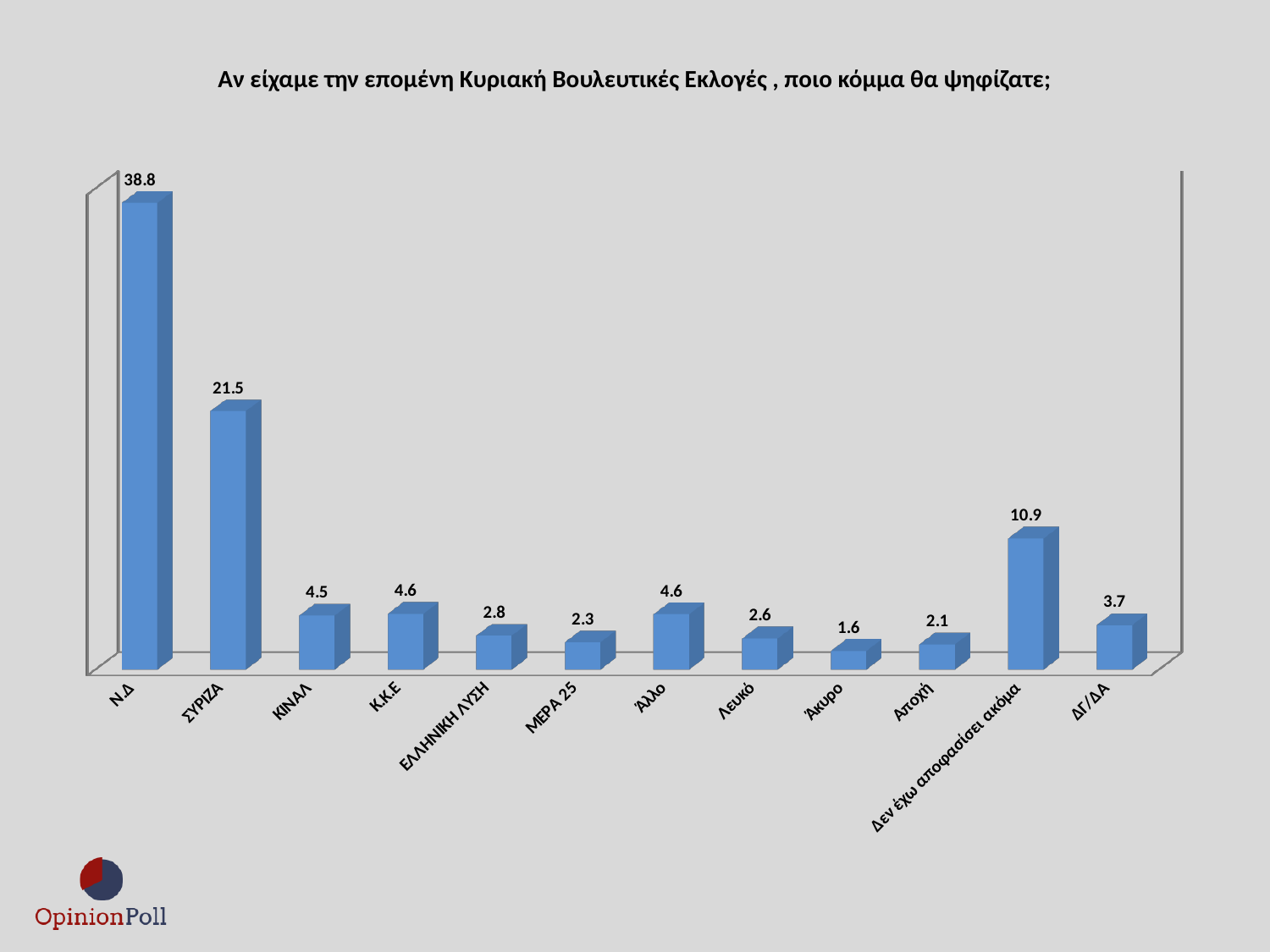
What is the value for ΕΛΛΗΝΙΚΗ ΛΥΣΗ? 2.8 What is the value for ΣΥΡΙΖΑ? 21.5 Which category has the highest value? Ν.Δ What is the difference between the values for Ν.Δ and ΣΥΡΙΖΑ? 17.3 What kind of chart is shown on the slide? Bar chart What is the value for ΔΓ/ΔΑ? 3.7 Which is larger, the value for Δεν έχω αποφασίσει ακόμα or the value for ΔΓ/ΔΑ? Δεν έχω αποφασίσει ακόμα How many categories are shown on the chart? 12 What is the title of the chart? Αν είχαμε την επομένη Κυριακή Βουλευτικές Εκλογές , ποιο κόμμα θα ψηφίζατε; Which category has the lowest value? Άκυρο What is the value for Δεν έχω αποφασίσει ακόμα? 10.9 What is the value for Ν.Δ? 38.8